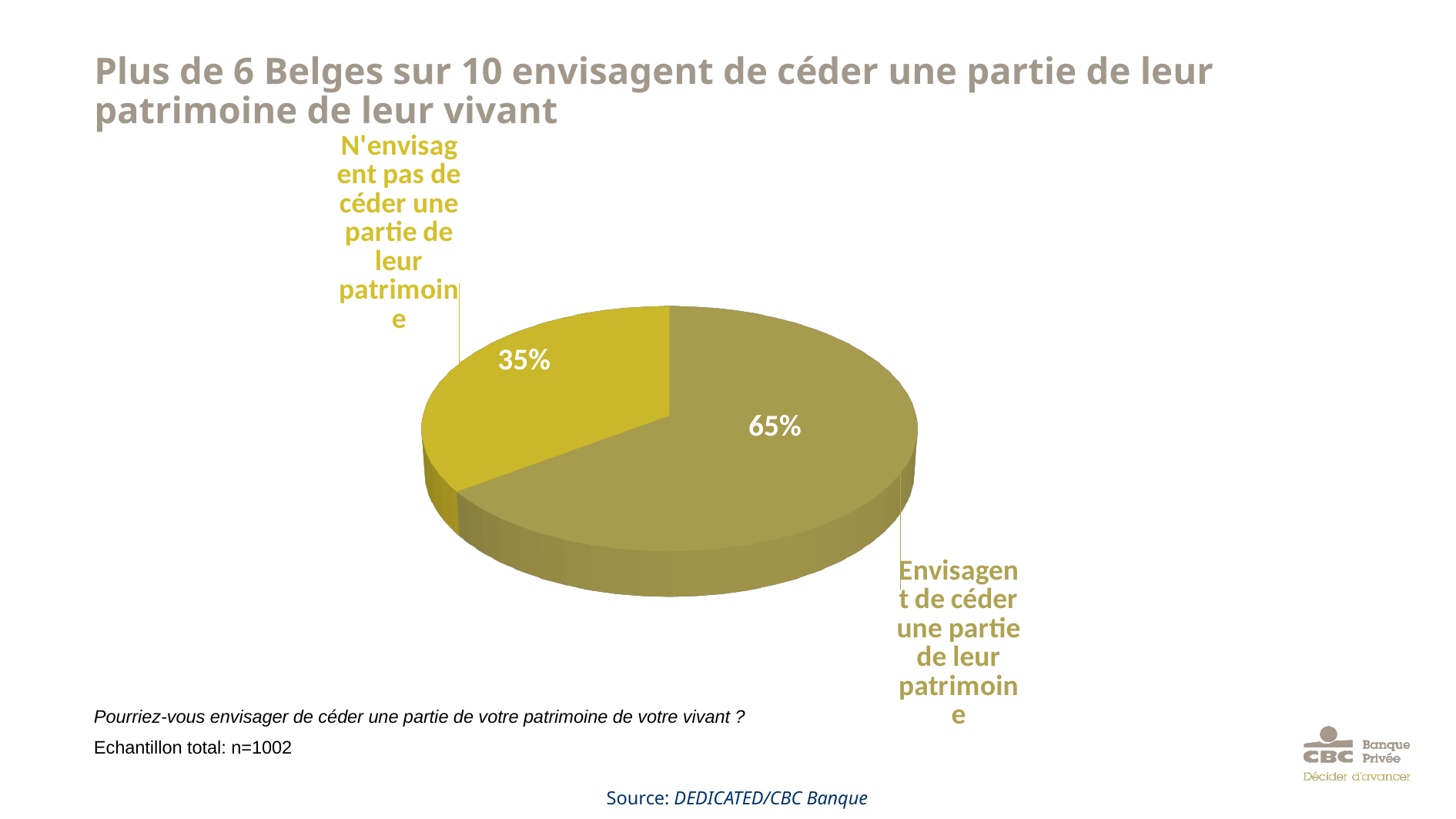
What is the difference in percentage points between the "Envisagent" slice and the "N'envisagent pas" slice? 30 percentage points What is the source cited for the chart data? DEDICATED/CBC Banque What percentage of respondents envisage ceding part of their patrimony during their lifetime ("Envisagent de céder une partie de leur patrimoine")? 65% What share of the pie does the "N'envisagent pas de céder une partie de leur patrimoine" slice represent? 35% How many slices does the pie chart have? 2 What type of chart is shown on the slide? Pie chart What is the total sample size (échantillon total) stated on the slide? n=1002 Which is larger: the share that envisages ceding part of their patrimony or the share that does not? Envisagent de céder une partie de leur patrimoine Which slice of the pie chart is the largest? Envisagent de céder une partie de leur patrimoine What percentage of respondents do not envisage ceding part of their patrimony ("N'envisagent pas de céder une partie de leur patrimoine")? 35% Which slice of the pie chart is the smallest? N'envisagent pas de céder une partie de leur patrimoine